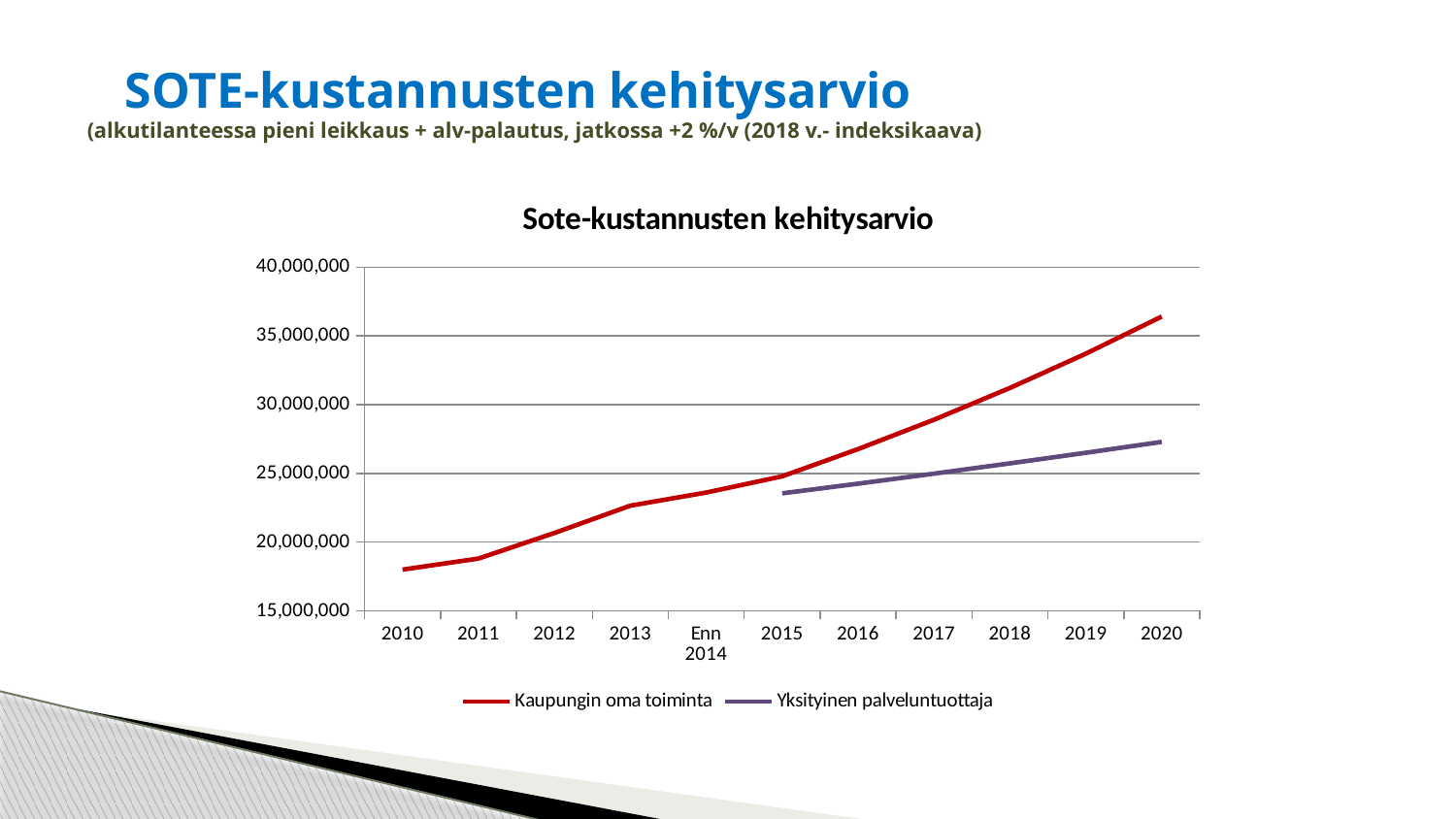
Is the value for Kaupungin oma toiminta in 2020 greater or less than 35,000,000? greater Is the value for Yksityinen palveluntuottaja in 2015 greater or less than 25,000,000? less In which year does Kaupungin oma toiminta reach its highest value? 2020 Is the value for Yksityinen palveluntuottaja in 2020 greater or less than 25,000,000? greater In 2020, which series has the higher value, Kaupungin oma toiminta or Yksityinen palveluntuottaja? Kaupungin oma toiminta Which series is drawn in red? Kaupungin oma toiminta What is the title of the chart? Sote-kustannusten kehitysarvio What kind of chart is shown on the slide? Line chart How many categories are shown on the x axis? 11 Do the values for Kaupungin oma toiminta rise or fall from 2010 to 2020? Rise How many series does the legend list? 2